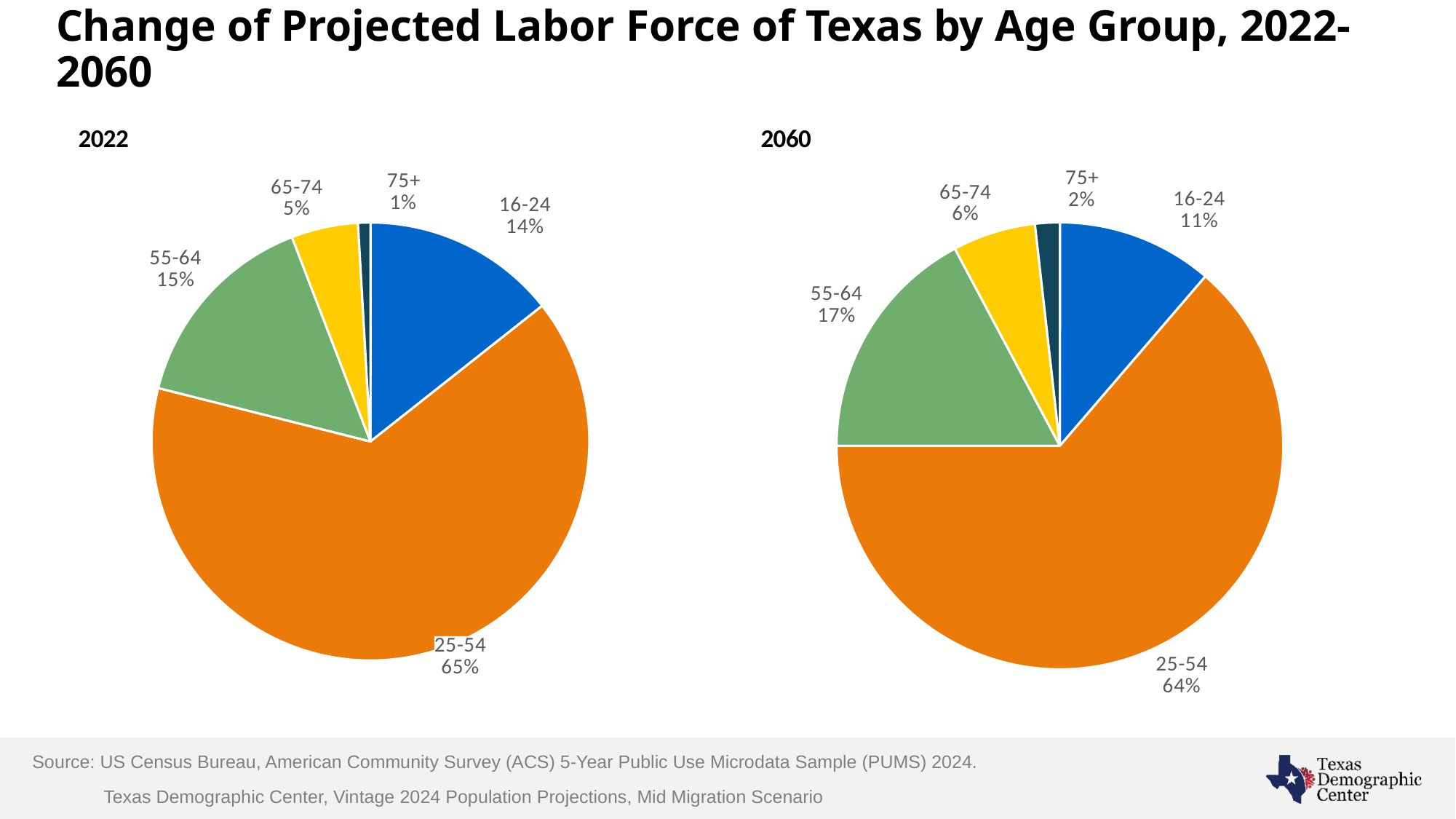
In the 2060 pie chart, which age group has the largest share? 25-54 What kind of chart is used to show the 2022 labor force by age group? Pie chart In the 2060 pie chart, what share of the labor force is the 55-64 age group? 17% What is the difference between the 16-24 share in the 2022 chart and the 16-24 share in the 2060 chart? 3% What is the title of the slide containing the two pie charts? Change of Projected Labor Force of Texas by Age Group, 2022-2060 In the 2060 pie chart, what share is shown for the 16-24 age group? 11% In the 2022 pie chart, what is the combined share of the 65-74 and 75+ age groups? 6% In the 2022 pie chart, which is larger: the share for 55-64 or the share for 65-74? 55-64 In the 2022 pie chart, which age group has the smallest share? 75+ In the 2022 pie chart, what share of the labor force is the 25-54 age group? 65% How many age groups are shown in the 2060 pie chart? 5 In the 2060 pie chart, what colour is the 25-54 slice? Orange